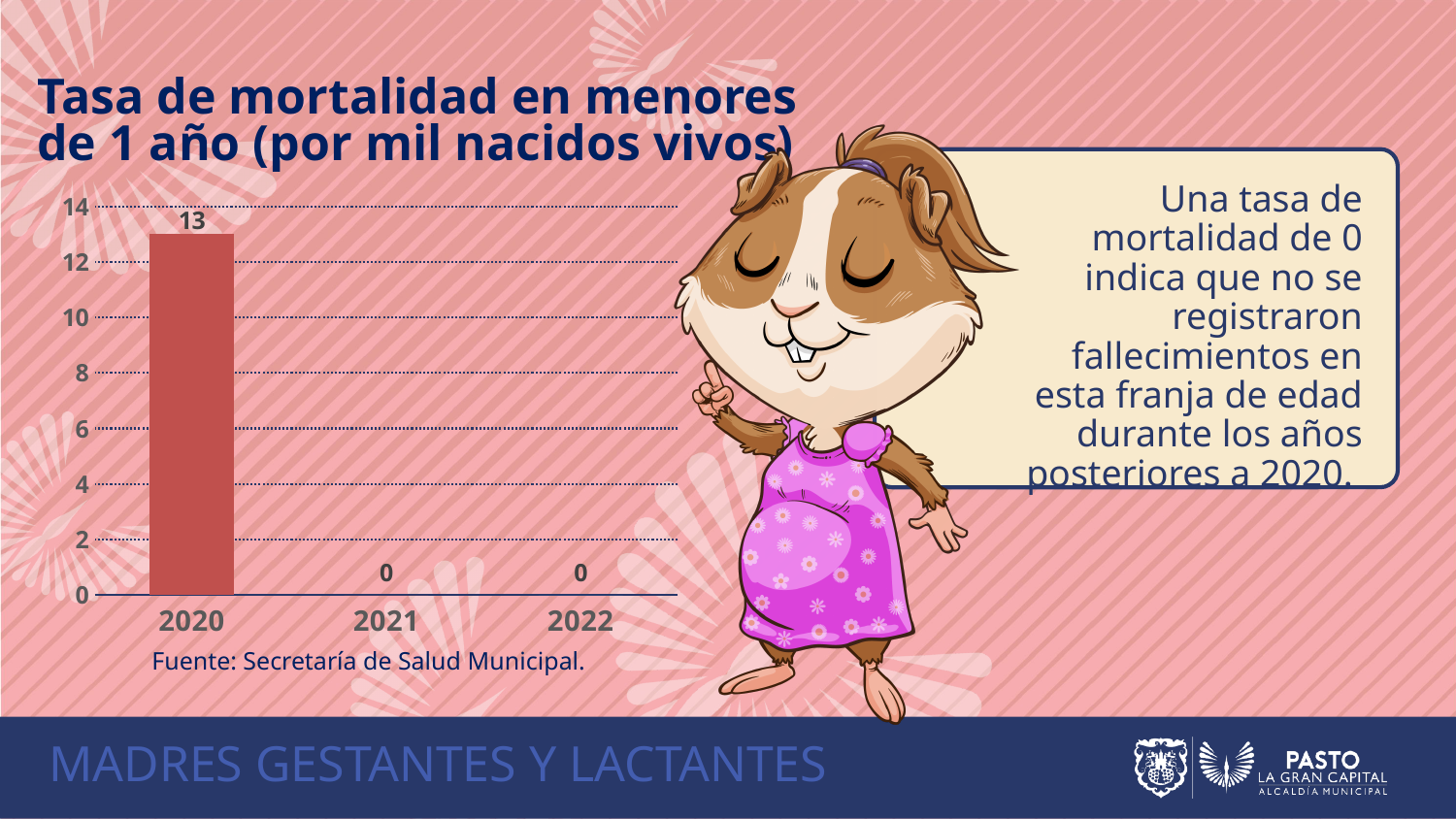
What is the mortality rate for 2022? 0 Which year has the highest mortality rate? 2020 Do the values rise or fall from 2020 to 2022? fall What is the mortality rate for 2020? 13 Which is larger, the value for 2020 or the value for 2022? 2020 What is the difference between the mortality rate in 2020 and in 2021? 13 What kind of chart is shown? bar chart Is the value for 2020 greater or less than 10? greater What is the title of the chart? Tasa de mortalidad en menores de 1 año (por mil nacidos vivos) What is the source cited below the chart? Secretaría de Salud Municipal What is the mortality rate for 2021? 0 How many years are shown on the x axis? 3